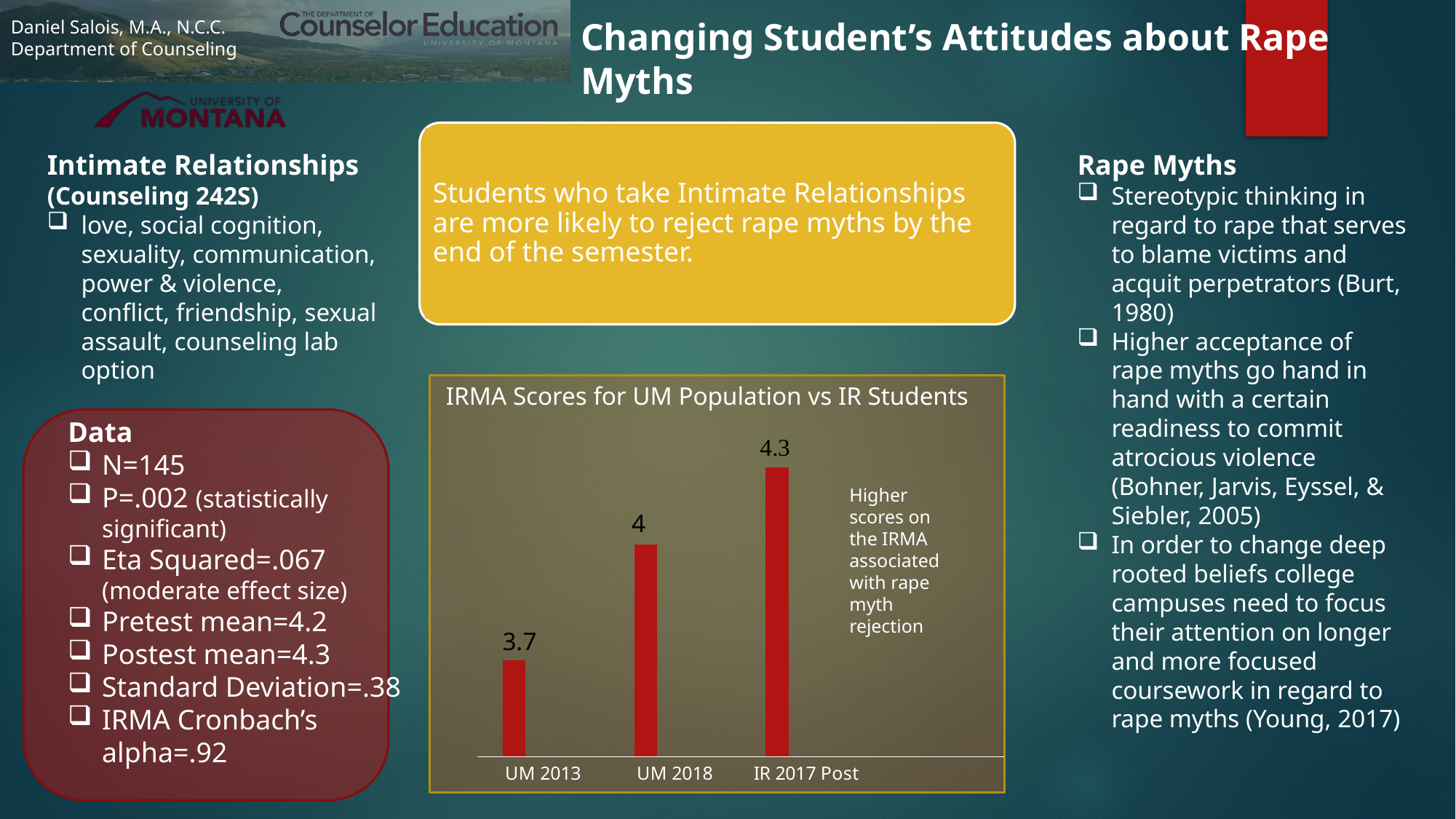
Which category has the lowest IRMA score? UM 2013 How many categories are shown in the chart? 3 What kind of chart is shown on the slide? Bar chart Which has a higher IRMA score, UM 2018 or IR 2017 Post? IR 2017 Post Do the IRMA scores rise or fall from left to right across the categories? Rise What is the IRMA score for UM 2018? 4 What is the title of the chart? IRMA Scores for UM Population vs IR Students What is the difference between the IRMA scores for UM 2018 and UM 2013? 0.3 What is the difference between the IRMA scores for IR 2017 Post and UM 2013? 0.6 Which category has the highest IRMA score? IR 2017 Post What is the IRMA score for UM 2013? 3.7 What is the IRMA score for IR 2017 Post? 4.3